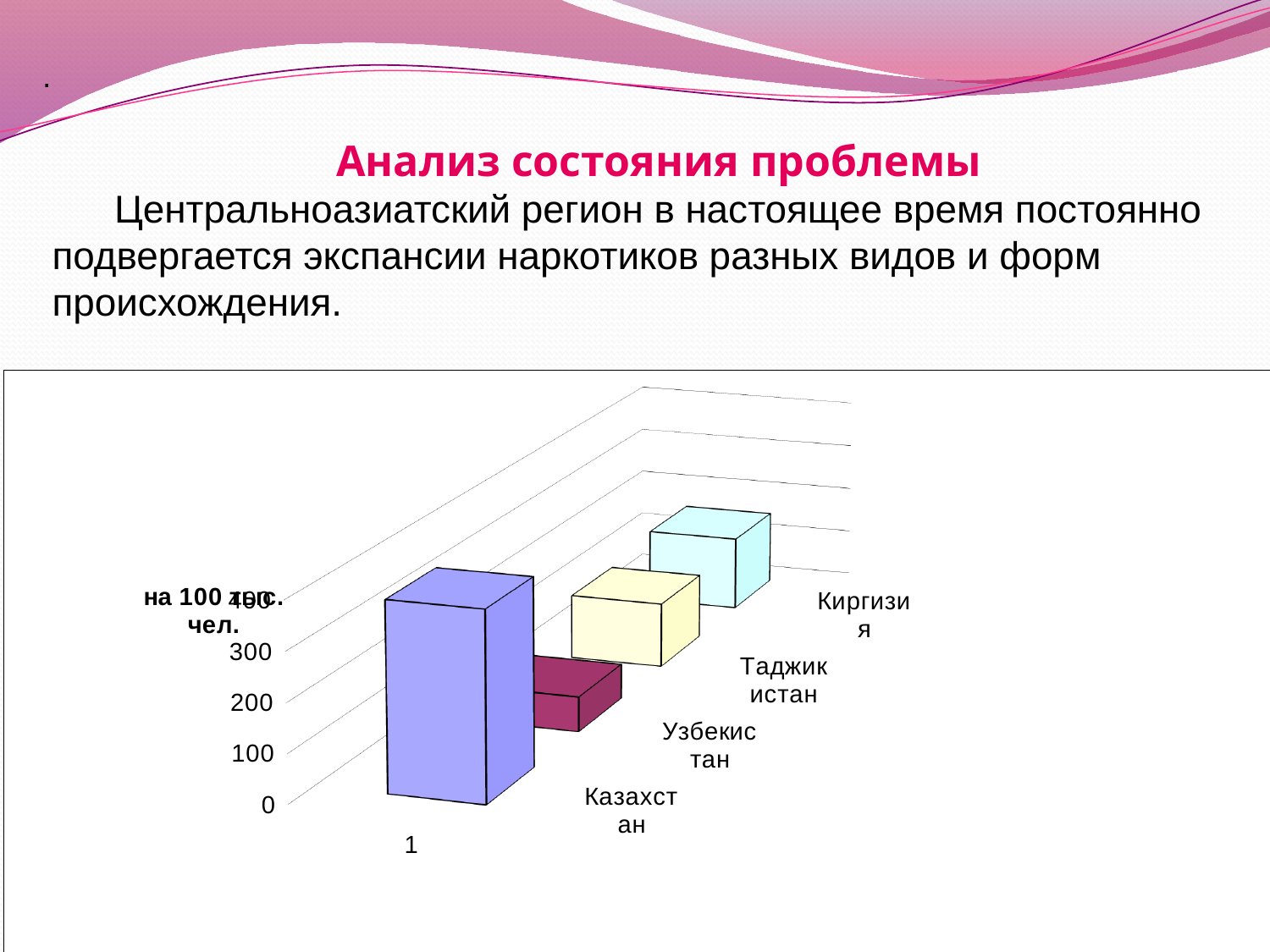
Which country has the lowest value in the chart? Узбекистан Which has the larger value, Казахстан or Узбекистан? Казахстан What kind of chart is shown on the slide? bar chart What is the label on the vertical axis of the chart? на 100 тыс. чел. Which has the larger value, Киргизия or Узбекистан? Киргизия Is the value for Казахстан greater or less than 300? greater Which country has the highest value in the chart? Казахстан What is the highest tick value shown on the vertical axis? 400 Is the value for Казахстан greater or less than 200? greater Which has the larger value, Казахстан or Таджикистан? Казахстан How many countries are shown in the chart? 4